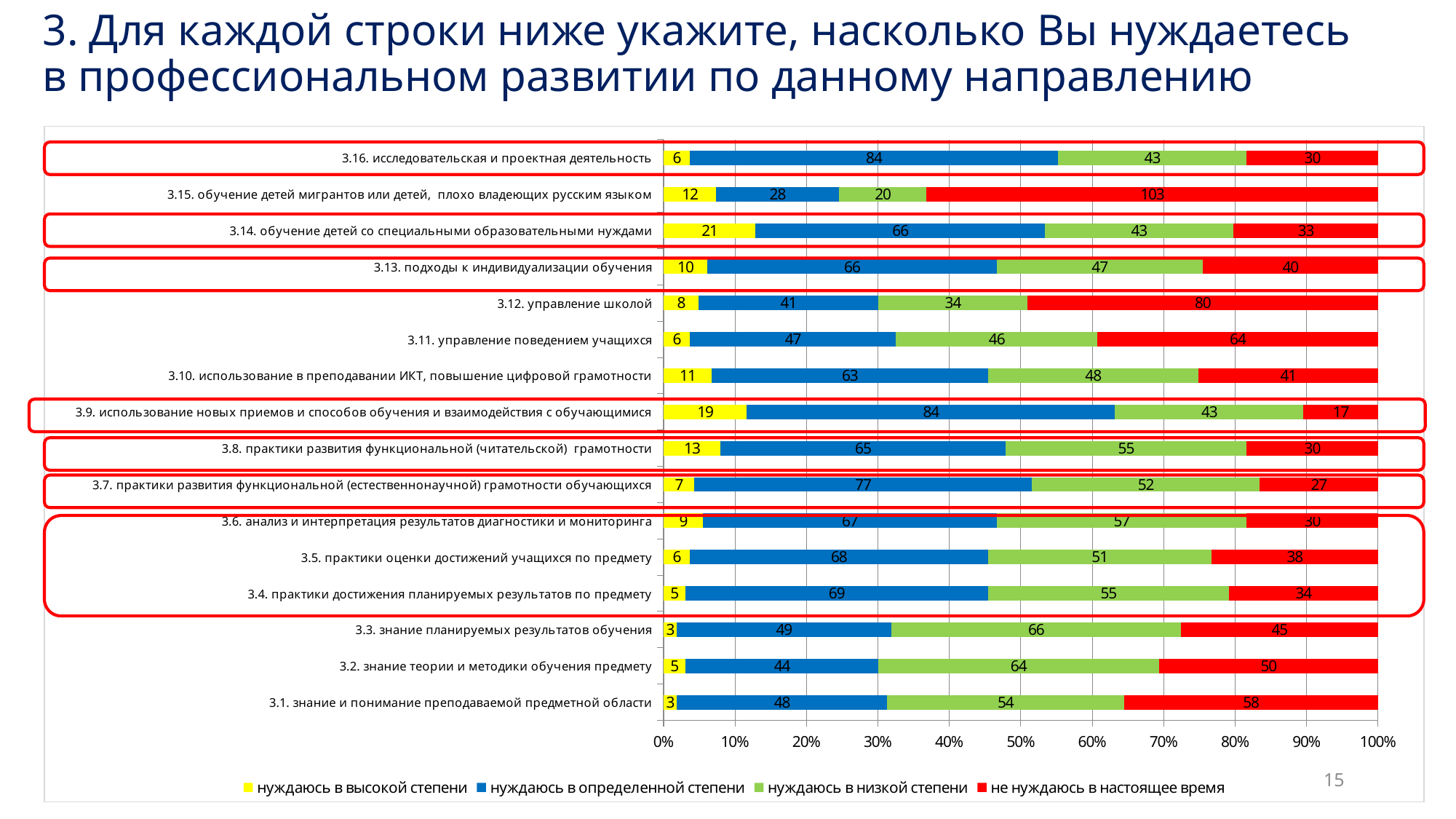
Which colour represents the 'нуждаюсь в высокой степени' series in the legend? Yellow How many series does the legend list? 4 Which category has the highest value in the 'нуждаюсь в высокой степени' series? 3.14. обучение детей со специальными образовательными нуждами What kind of chart is shown on the slide? Stacked bar chart What is the difference between the 'не нуждаюсь в настоящее время' values for '3.12. управление школой' and '3.13. подходы к индивидуализации обучения'? 40 What is the value of the 'нуждаюсь в определенной степени' series for '3.16. исследовательская и проектная деятельность'? 84 What is the value of the 'не нуждаюсь в настоящее время' series for '3.15. обучение детей мигрантов или детей, плохо владеющих русским языком'? 103 What is the value of the 'нуждаюсь в низкой степени' series for '3.3. знание планируемых результатов обучения'? 66 Which is larger: the 'нуждаюсь в определенной степени' value for '3.7. практики развития функциональной (естественнонаучной) грамотности обучающихся' or for '3.8. практики развития функциональной (читательской) грамотности'? 3.7. практики развития функциональной (естественнонаучной) грамотности обучающихся Which category has the highest value in the 'не нуждаюсь в настоящее время' series? 3.15. обучение детей мигрантов или детей, плохо владеющих русским языком What is the total of all segments in the bar for '3.9. использование новых приемов и способов обучения и взаимодействия с обучающимися'? 163 How many categories are shown on the chart? 16